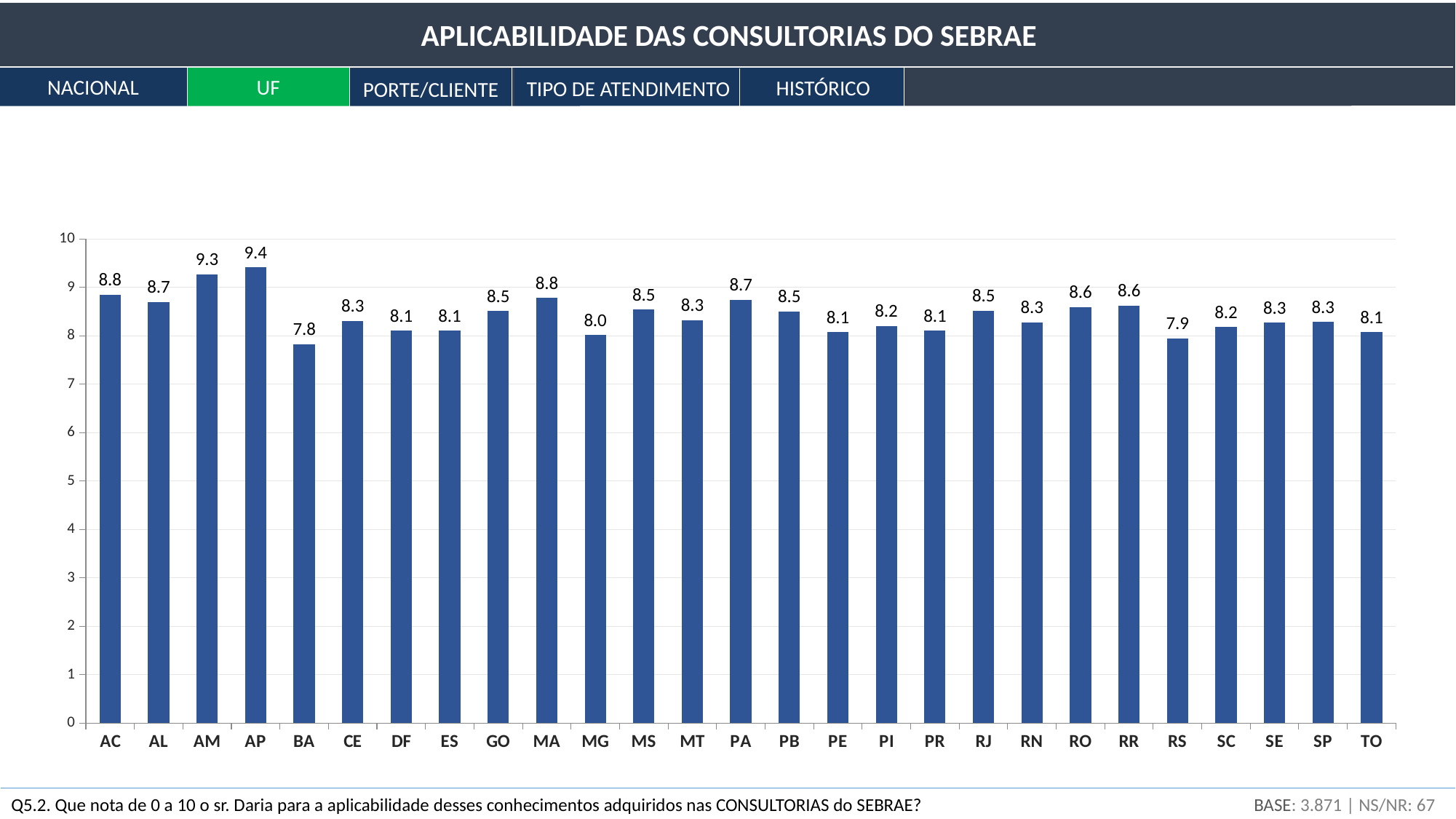
Which category has the lowest value? BA How many categories are shown on the x axis? 27 What kind of chart is shown on the slide? Bar chart What is the title shown at the top of the slide? APLICABILIDADE DAS CONSULTORIAS DO SEBRAE What is the value for MG? 8.0 What is the value for BA? 7.8 Which category has the highest value? AP What is the value for RS? 7.9 What is the difference between the values for AM and AC? 0.5 Which is larger, the value for AM or the value for MA? AM What is the difference between the values for AP and BA? 1.6 What is the value for AP? 9.4